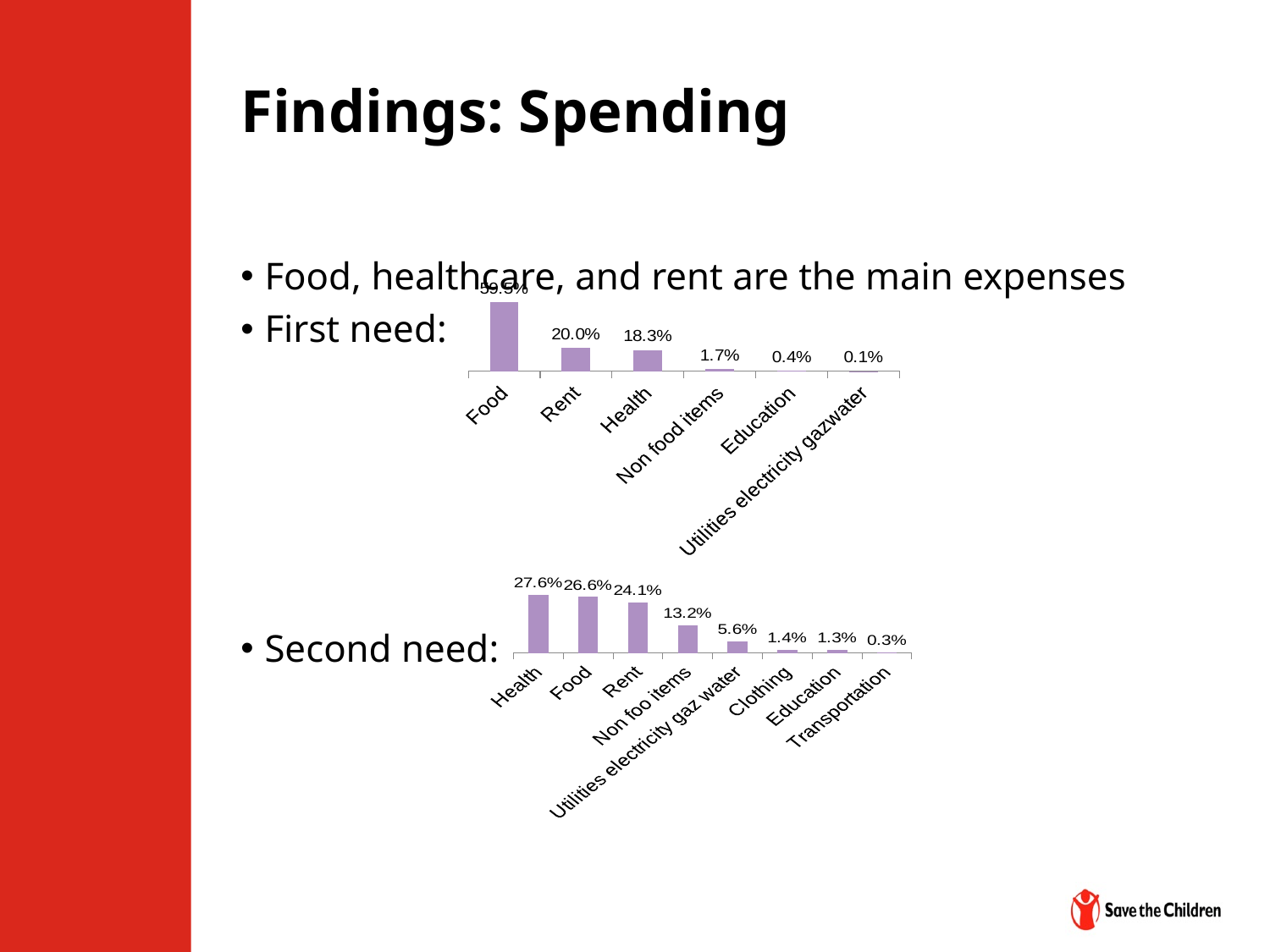
In the Second need chart, which category has the lowest value? Transportation In the First need chart, what is the difference between Rent and Health? 1.7% In the First need chart, what is the value for Health? 18.3% How many categories are shown in the First need chart? 6 In the First need chart, what is the value for Rent? 20.0% How many categories are shown in the Second need chart? 8 What kind of chart is the Second need chart? Bar chart In the Second need chart, what is the value for Non foo items? 13.2% In the First need chart, which category has the lowest value? Utilities electricity gazwater In the First need chart, which category has the highest value? Food In the Second need chart, what is the value for Health? 27.6% In the Second need chart, what is the difference between Food and Rent? 2.5%